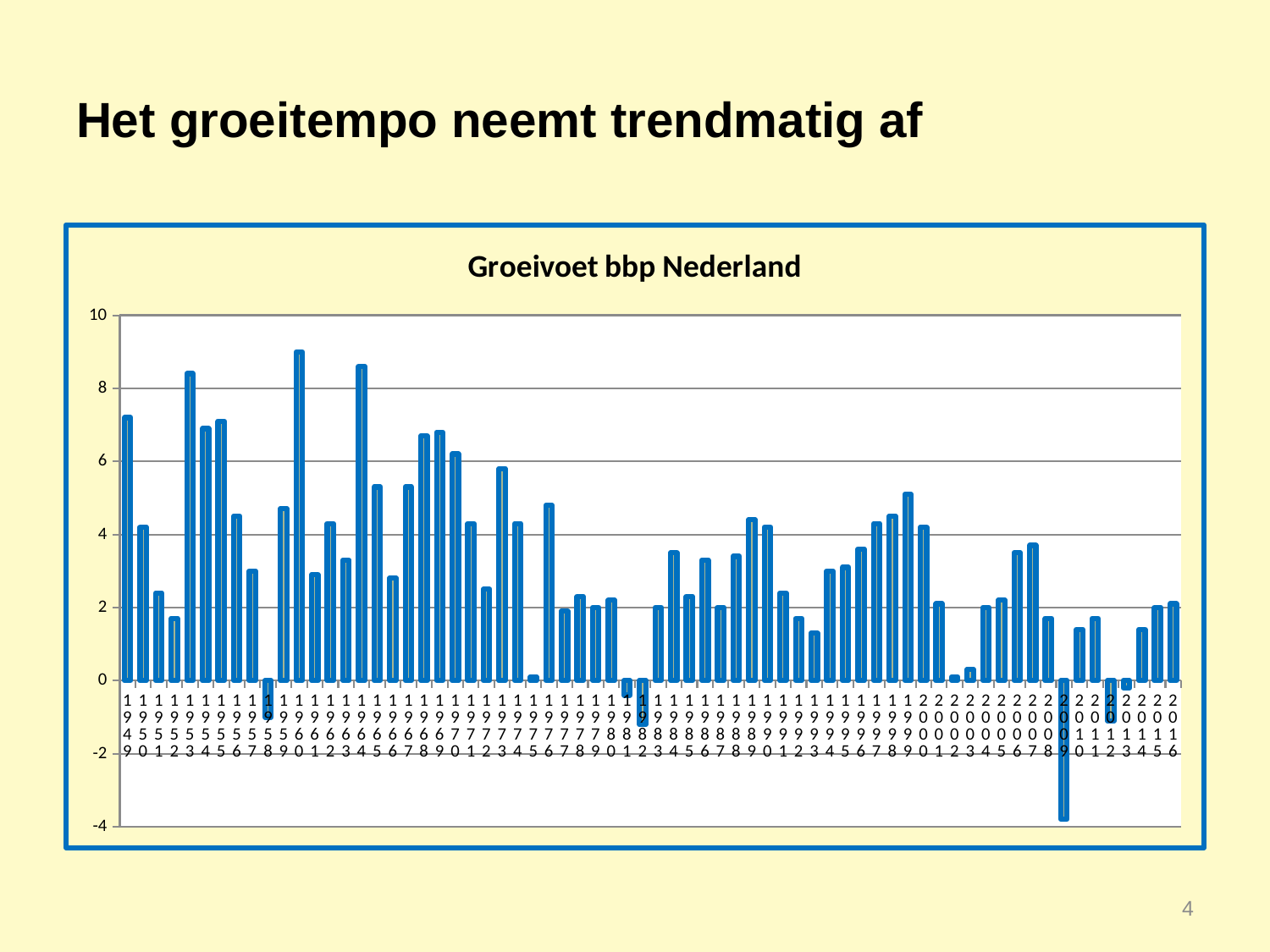
Is the value for 2009 greater or less than -2? less Which year has the lowest value in the chart? 2009 Is the value for 1982 greater or less than 0? less Do the growth rates generally rise or fall over the period shown? fall What kind of chart is shown on the slide? bar chart Is the value for 1949 greater or less than 6? greater What is the title of the chart? Groeivoet bbp Nederland Which is larger, the value for 2009 or the value for 2010? 2010 Which is larger, the value for 1949 or the value for 1950? 1949 How many years (bars) are plotted in the chart? 68